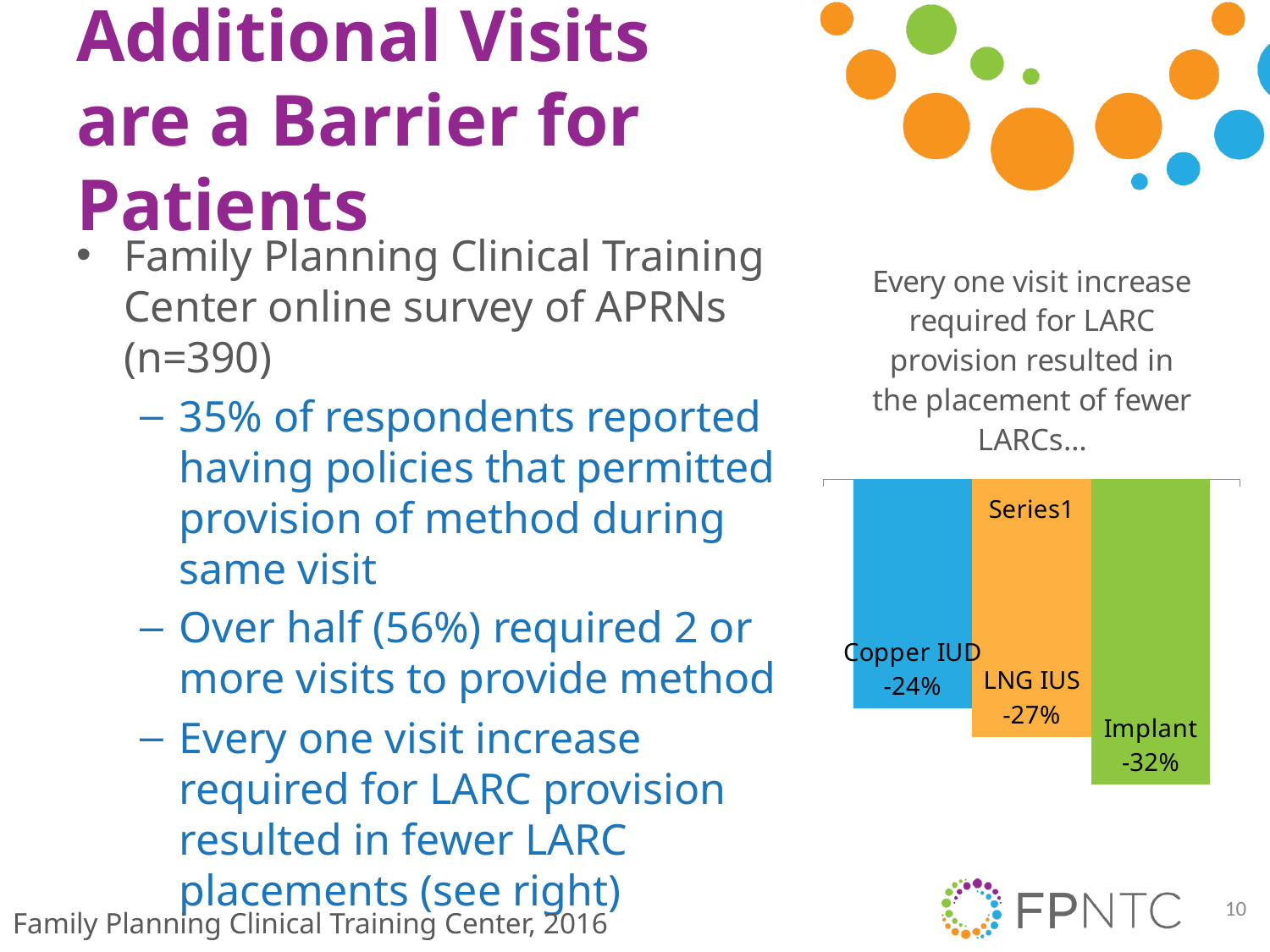
What is the value for Implant in the chart? -32% What is the difference in percentage points between the LNG IUS value and the Copper IUD value? 3 percentage points Do the values fall or rise moving from Copper IUD to Implant along the x axis? Fall What is the value for Copper IUD in the chart? -24% Which has a larger decrease, LNG IUS or Implant? Implant Which category shows the largest decrease (lowest value) in the chart? Implant What series name is printed on the chart? Series1 What is the value for LNG IUS in the chart? -27% How many categories are shown in the chart? 3 What kind of chart is shown on the slide? Bar chart What is the difference in percentage points between the Implant value and the Copper IUD value? 8 percentage points Which category shows the smallest decrease (highest value) in the chart? Copper IUD